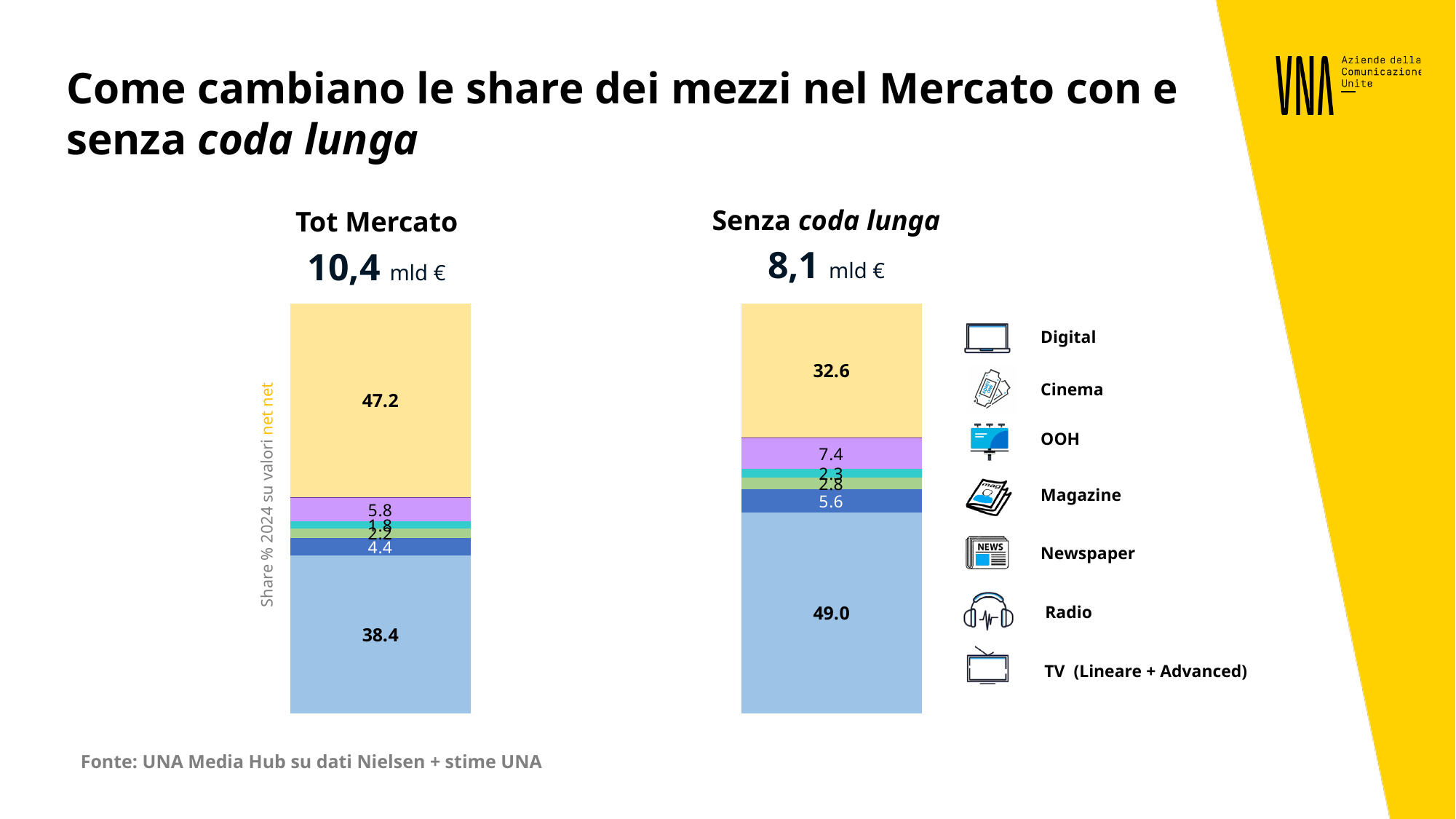
What is the value of the light-blue bottom segment in the Senza coda lunga bar? 49.0 What is the value of the yellow top segment in the Senza coda lunga bar? 32.6 What is the value of the yellow top segment in the Tot Mercato bar? 47.2 What total market value in mld € is shown above the Tot Mercato bar? 10,4 mld € What is the difference between the yellow top segment in the Tot Mercato bar and the yellow top segment in the Senza coda lunga bar? 14.6 What is the value of the purple segment in the Senza coda lunga bar? 7.4 Is the light-blue bottom segment larger in the Tot Mercato bar or in the Senza coda lunga bar? Senza coda lunga Which segment is the largest in the Senza coda lunga bar? The light-blue bottom segment (49.0) What is the value of the dark-blue segment in the Tot Mercato bar? 4.4 What is the value of the light-blue bottom segment in the Tot Mercato bar? 38.4 Which segment is the largest in the Tot Mercato bar? The yellow top segment (47.2) What kind of chart is used on this slide? Stacked bar chart